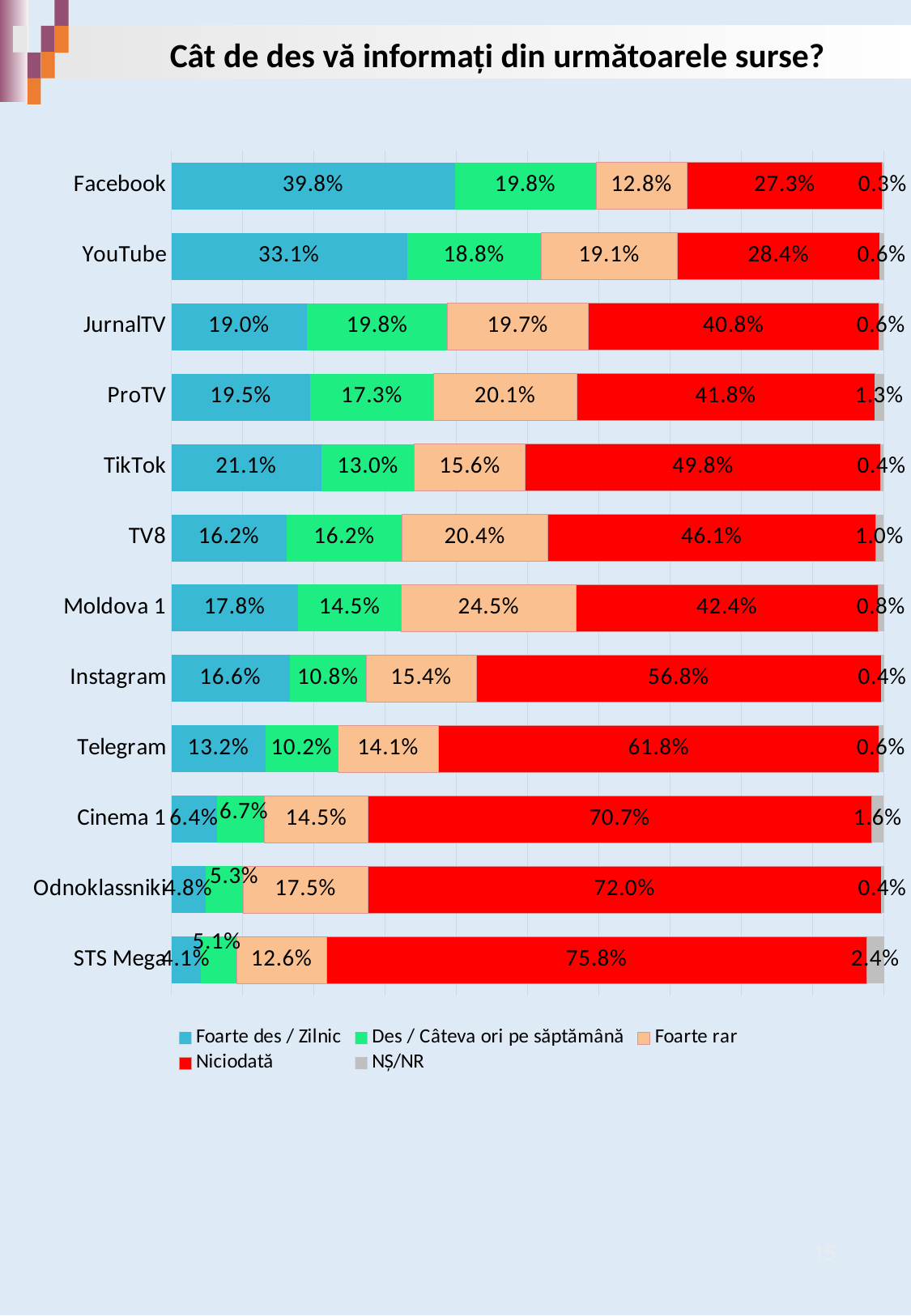
What is the 'Niciodată' value for Telegram? 61.8% Which is larger: the 'Foarte des / Zilnic' value for YouTube or for TikTok? YouTube How many series does the legend list? 5 What is the 'NȘ/NR' value for ProTV? 1.3% What kind of chart is shown on the slide? Stacked bar chart How many sources are listed on the chart? 12 What percentage of respondents use Facebook 'Foarte des / Zilnic'? 39.8% What is the 'Foarte rar' value for Moldova 1? 24.5% Which source has the lowest 'Foarte des / Zilnic' percentage? STS Mega What colour represents 'Niciodată' in the chart? Red What is the difference between the 'Niciodată' values for Instagram and Facebook? 29.5% Which source has the highest 'Niciodată' percentage? STS Mega